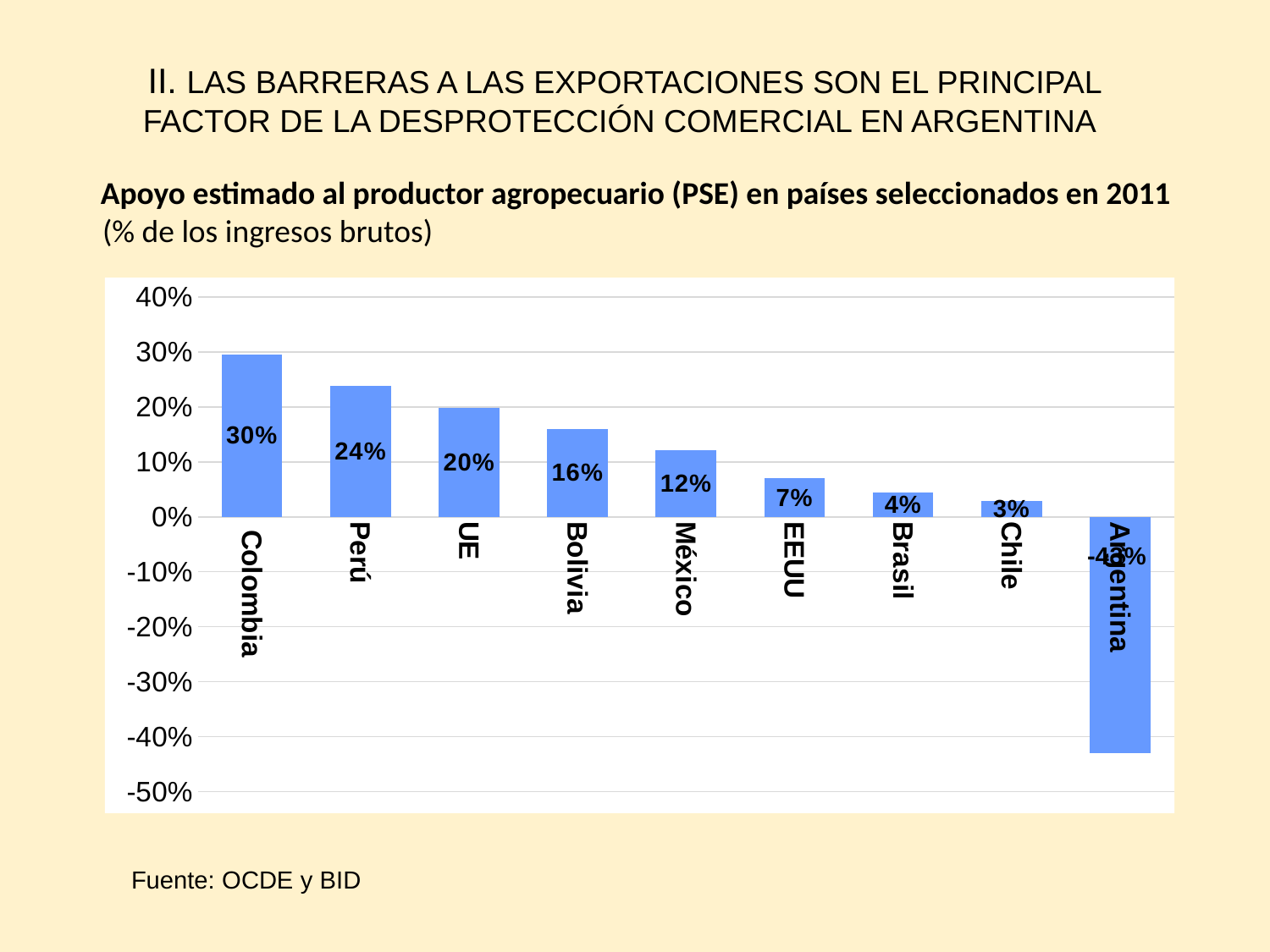
Do the values rise or fall moving from left to right along the x axis? fall What is the PSE value shown for Colombia? 30% How many countries or regions are shown in the chart? 9 What is the difference between the PSE values for Colombia and Perú? 6 percentage points What is the PSE value shown for Bolivia? 16% What is the PSE value shown for Chile? 3% What is the PSE value shown for Perú? 24% Which country has the lowest PSE value in the chart? Argentina Which has a higher PSE value, México or EEUU? México What kind of chart is shown on the slide? bar chart Which country has the highest PSE value in the chart? Colombia Is the value for Argentina greater or less than -40%? less